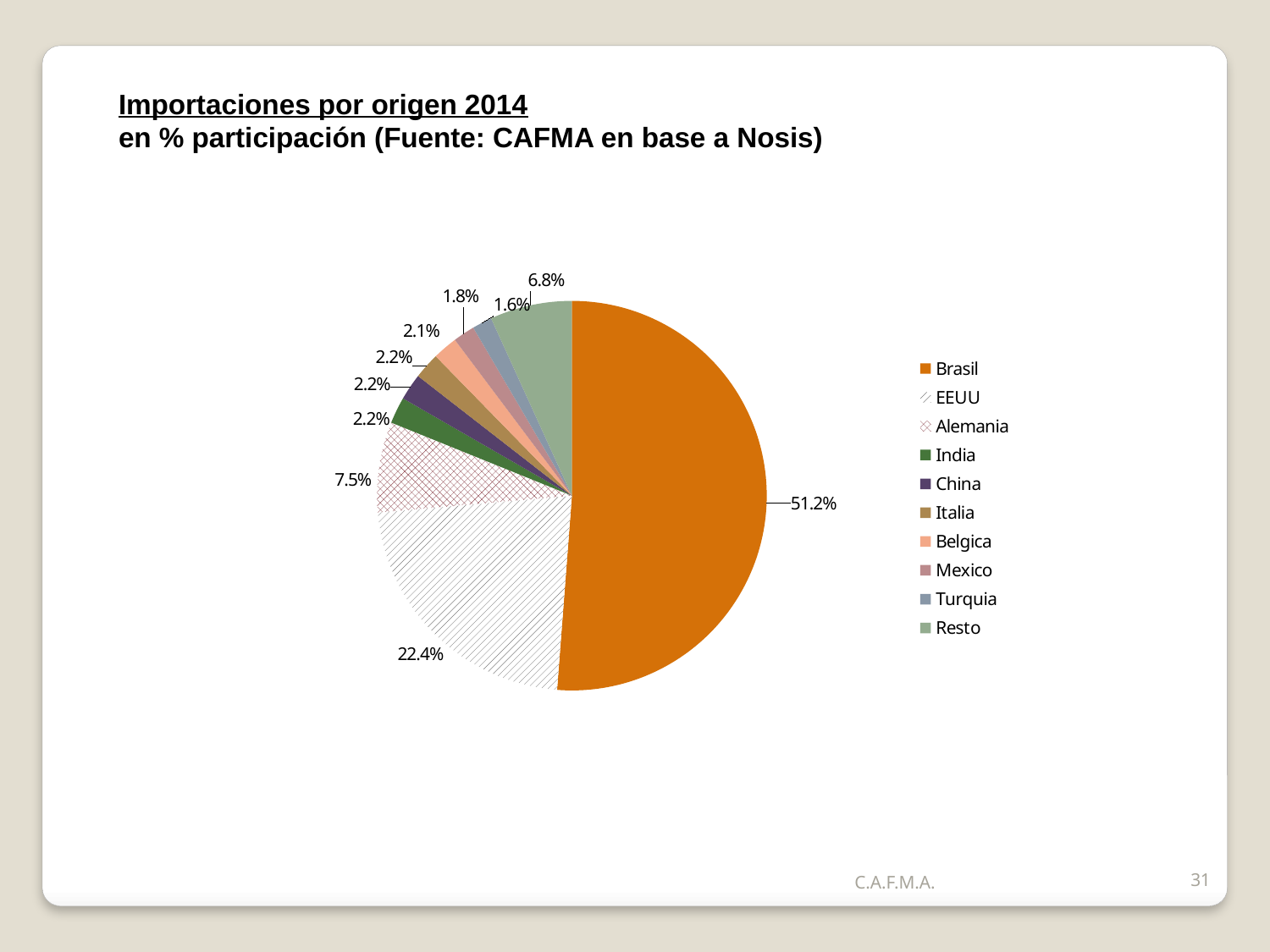
How many origins does the legend list? 10 Which origin has the largest share of imports in 2014? Brasil Which has a larger share of imports, Alemania or Resto? Alemania What share of imports in 2014 came from Brasil? 51.2% What share of imports in 2014 came from Alemania? 7.5% What kind of chart is shown on the slide? pie chart What is the title of the chart on the slide? Importaciones por origen 2014 en % participación (Fuente: CAFMA en base a Nosis) Which origin has the smallest share of imports in 2014? Turquia What share of imports in 2014 came from EEUU? 22.4% What share of imports in 2014 came from Mexico? 1.8% What is the difference in percentage points between the shares of Brasil and EEUU? 28.8 What share of imports in 2014 is labelled Resto? 6.8%